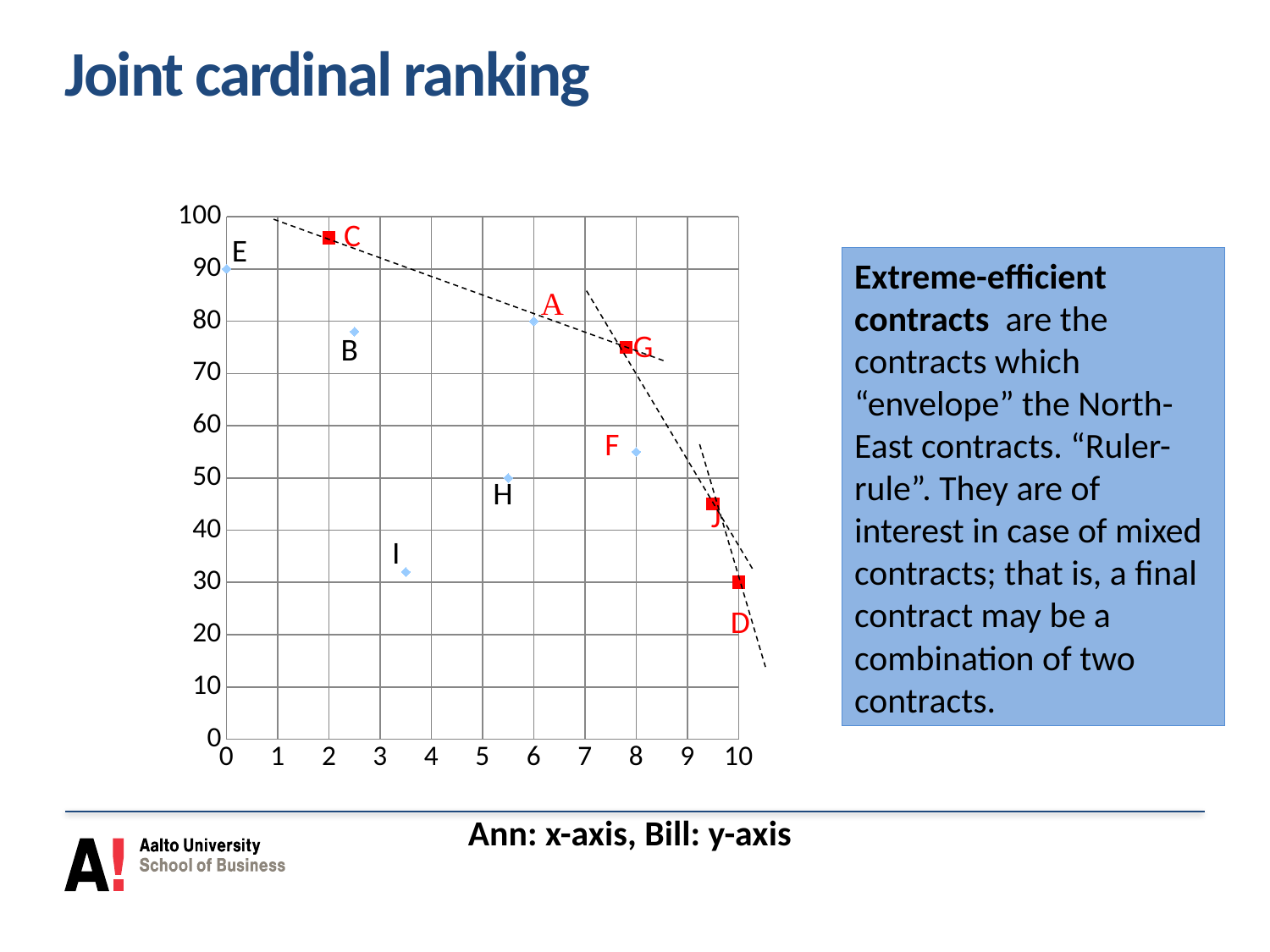
What is the y-axis value of point A? 80 What is the y-axis value of point E? 90 How many labelled points are plotted on the chart? 10 Is the y-axis value for point J greater or less than 50? less According to the slide, which person does the x-axis represent? Ann Is the y-axis value for point C greater or less than 90? greater What is the x-axis value of point D? 10 Which labelled point has the lowest y-axis (Bill) value? D Which labelled point has the highest x-axis (Ann) value? D Which labelled point has the highest y-axis (Bill) value? C What kind of chart is shown on the slide? scatter chart Which point has a larger y-axis value, A or F? A